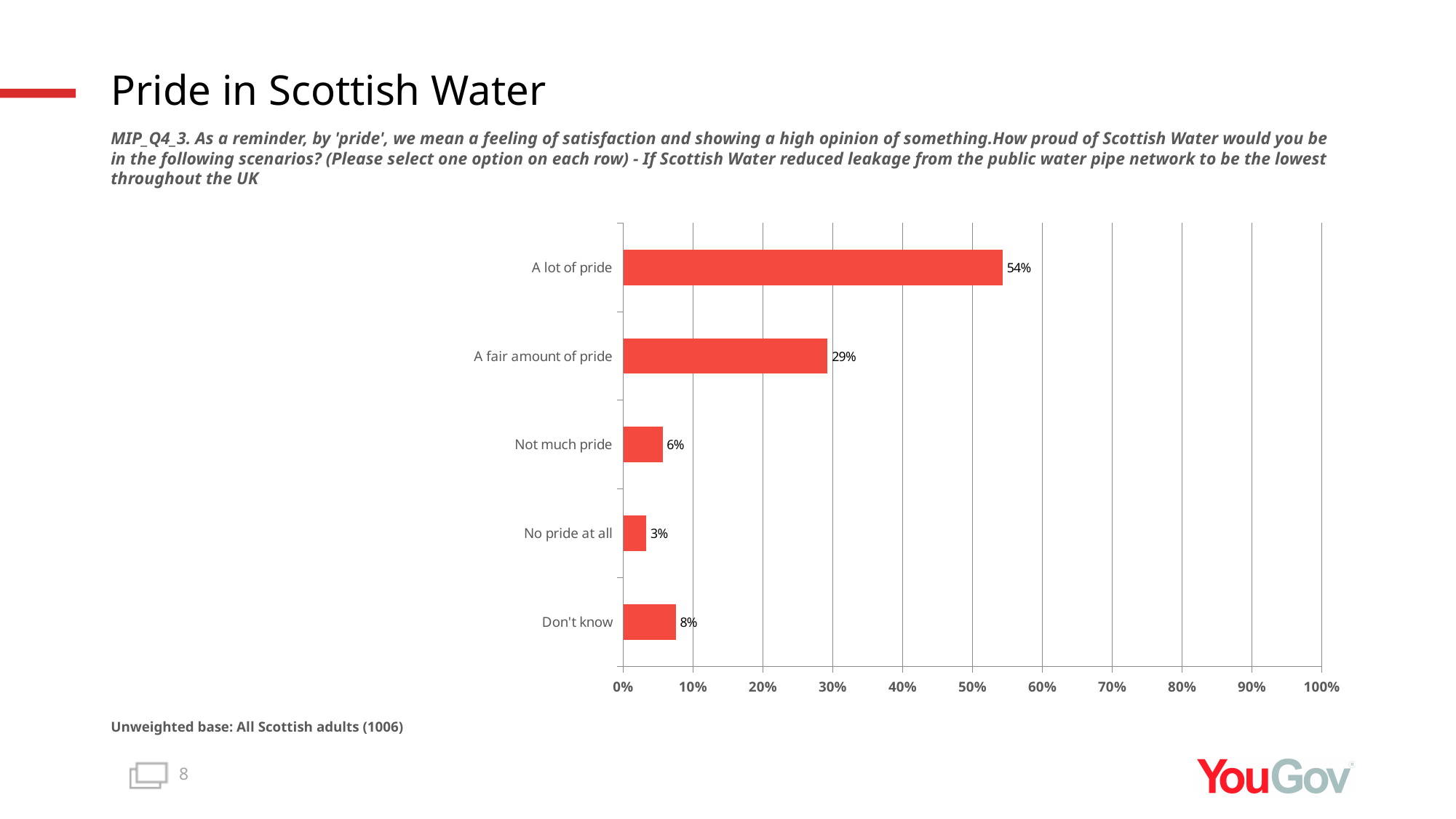
What is the unweighted base stated below the chart? All Scottish adults (1006) What percentage of respondents said they would feel 'A lot of pride'? 54% Which response category has the lowest value? No pride at all What is the value shown for 'A fair amount of pride'? 29% What is the difference between 'A lot of pride' and 'A fair amount of pride'? 25% What is the value for 'No pride at all'? 3% How many response categories are shown in the chart? 5 Is the value for 'A lot of pride' greater or less than 50%? greater Which response category has the highest value? A lot of pride What percentage answered 'Don't know'? 8% Which is larger: 'Not much pride' or 'Don't know'? Don't know What type of chart is shown on the slide? Bar chart